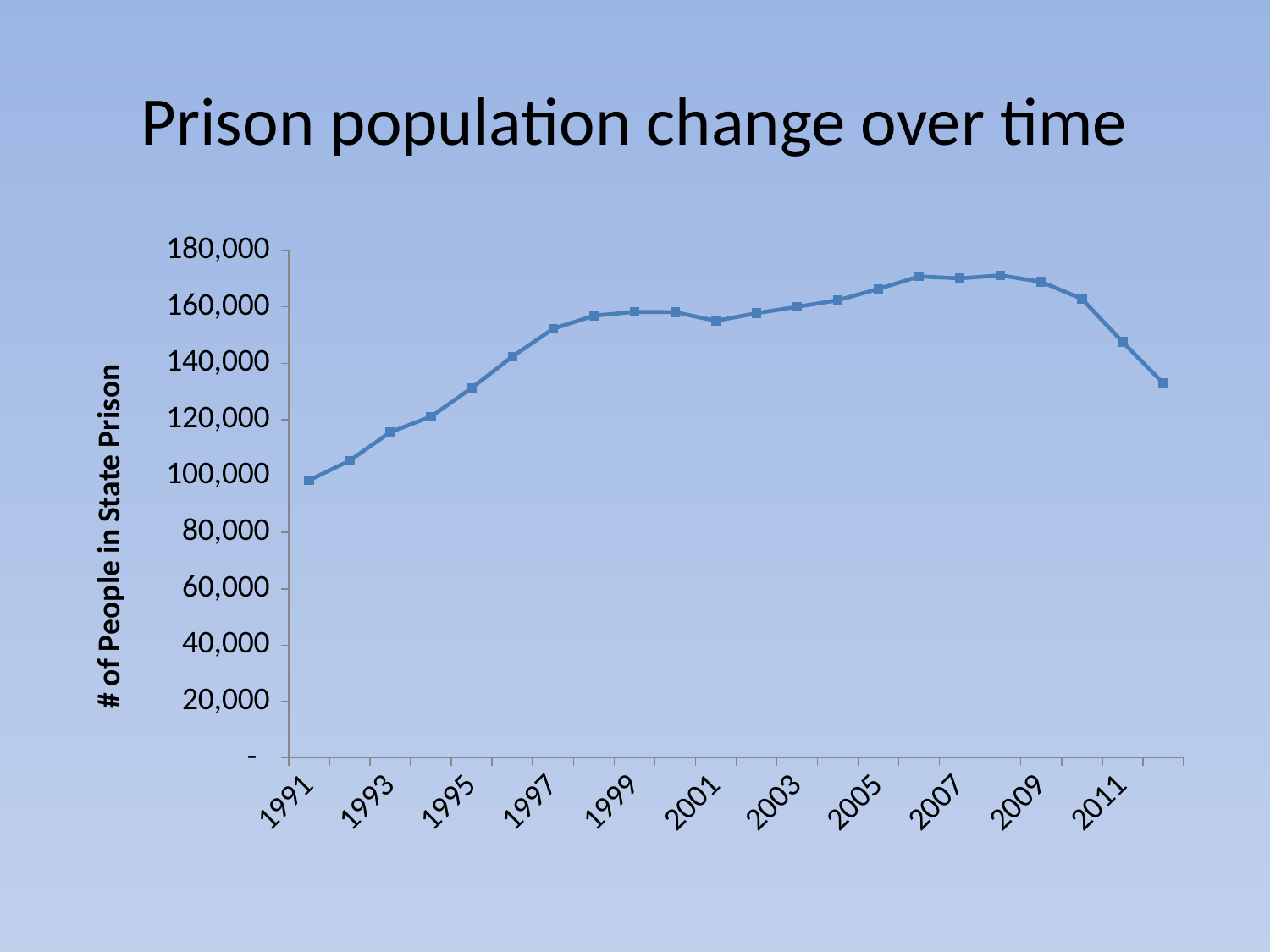
What kind of chart is shown on the slide? line chart Which year has the larger value, 1991 or 2012? 2012 Is the value for 2008 greater or less than 160,000? greater Is the value for 1991 greater or less than 120,000? less Is the value for 2012 greater or less than 120,000? greater What is the title of the chart? Prison population change over time Which year has the lowest number of people in state prison? 1991 What is the label on the vertical axis of the chart? # of People in State Prison How many data points are plotted on the line? 22 Does the prison population generally rise or fall from 1991 to 2008? rise